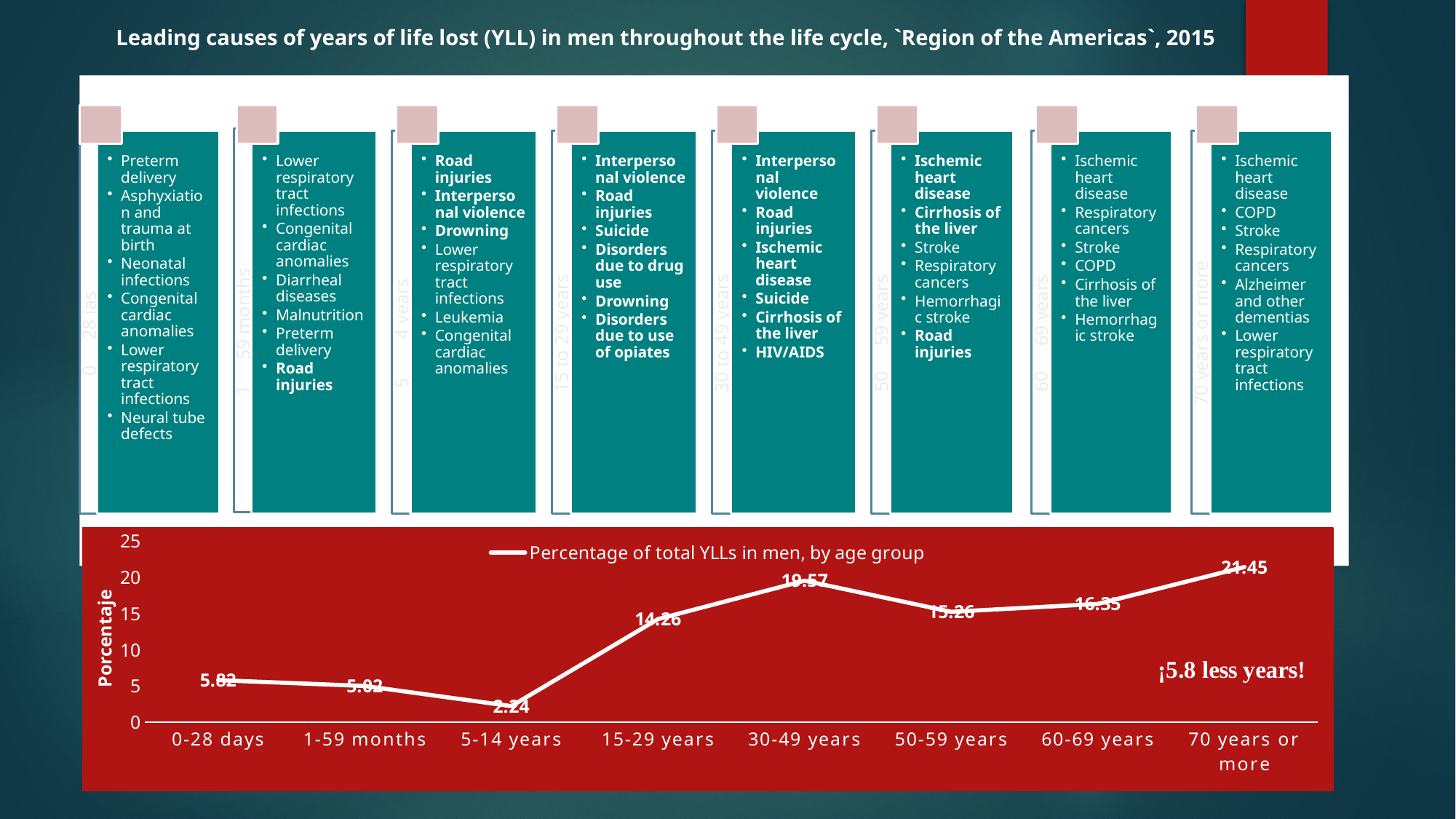
Which age group has the highest percentage of total YLLs in men? 70 years or more What is the percentage of total YLLs in men for the 0-28 days age group? 5.82 What type of chart is shown at the bottom of the slide? Line chart What is the percentage of total YLLs in men for the 5-14 years age group? 2.24 What is the difference between the percentage for 70 years or more and the percentage for 60-69 years? 5.1 Which age group has the lowest percentage of total YLLs in men? 5-14 years How many series does the legend of the line chart list? 1 Which has a larger percentage of total YLLs in men: 15-29 years or 50-59 years? 50-59 years What is the percentage of total YLLs in men for the 30-49 years age group? 19.57 How many age groups are plotted on the x axis of the line chart? 8 Is the value for 1-59 months greater or less than 10? less What is the label on the vertical axis of the line chart? Porcentaje